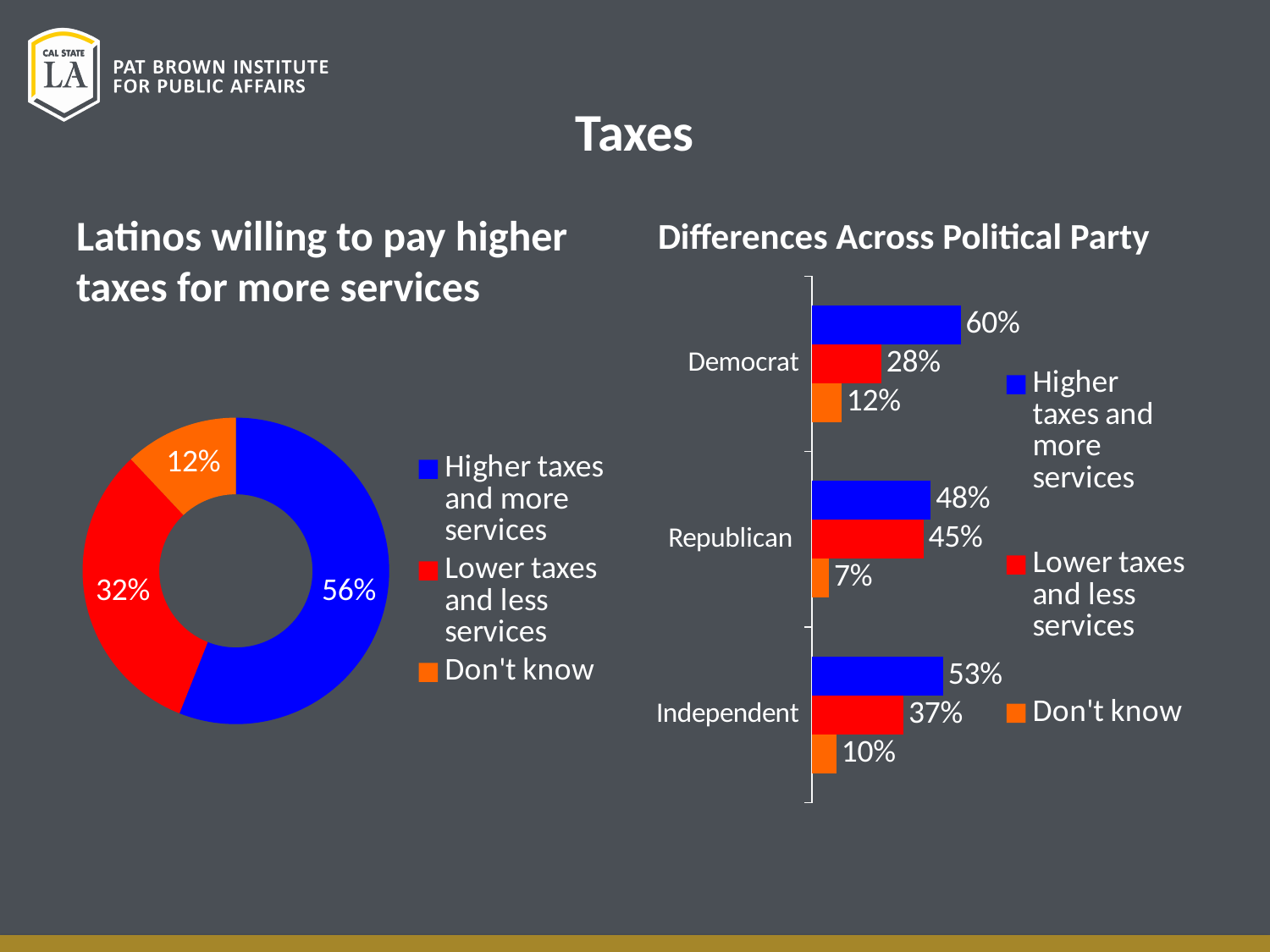
In the left chart (Latinos willing to pay higher taxes for more services), how many percentage points larger is 'Higher taxes and more services' than 'Lower taxes and less services'? 24 percentage points In the left chart (Latinos willing to pay higher taxes for more services), what share chose 'Don't know'? 12% What kind of chart is the left chart (Latinos willing to pay higher taxes for more services)? Doughnut (pie) chart In the 'Differences Across Political Party' chart, how many series does the legend list? 3 What kind of chart is the 'Differences Across Political Party' chart? Bar chart In the 'Differences Across Political Party' chart, what is the value for 'Lower taxes and less services' among Independents? 37% In the 'Differences Across Political Party' chart, what is the value for 'Don't know' among Republicans? 7% In the left chart (Latinos willing to pay higher taxes for more services), what share chose 'Higher taxes and more services'? 56% In the 'Differences Across Political Party' chart, which party has the highest value for 'Higher taxes and more services'? Democrat In the 'Differences Across Political Party' chart, what is the value for 'Higher taxes and more services' among Democrats? 60% In the left chart (Latinos willing to pay higher taxes for more services), which response has the smallest share? Don't know In the 'Differences Across Political Party' chart, which is larger for Republicans: 'Higher taxes and more services' or 'Lower taxes and less services'? Higher taxes and more services